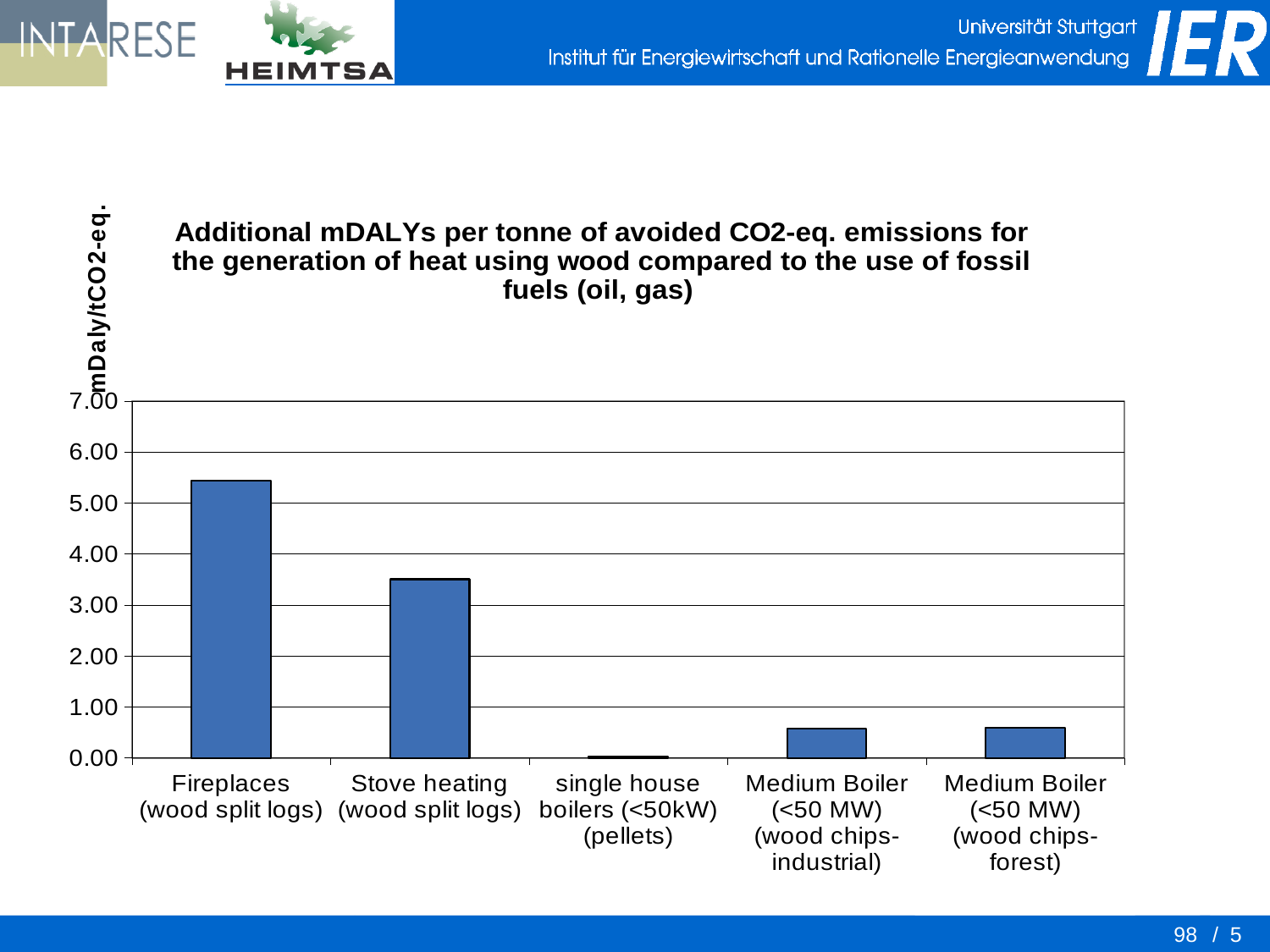
Which category has the lowest value in the chart? single house boilers (<50kW) (pellets) Which is larger, the value for Stove heating (wood split logs) or the value for Medium Boiler (<50 MW) (wood chips-forest)? Stove heating (wood split logs) What is the title of the chart? Additional mDALYs per tonne of avoided CO2-eq. emissions for the generation of heat using wood compared to the use of fossil fuels (oil, gas) What kind of chart is shown on the slide? bar chart Is the value for Fireplaces (wood split logs) greater or less than 5.00? greater Which is larger, the value for Fireplaces (wood split logs) or the value for Stove heating (wood split logs)? Fireplaces (wood split logs) How many categories are plotted on the x axis of the chart? 5 Is the value for Stove heating (wood split logs) greater or less than 3.00? greater Which category has the highest value in the chart? Fireplaces (wood split logs) Is the value for Fireplaces (wood split logs) greater or less than 6.00? less What is the label on the y axis of the chart? mDaly/tCO2-eq.